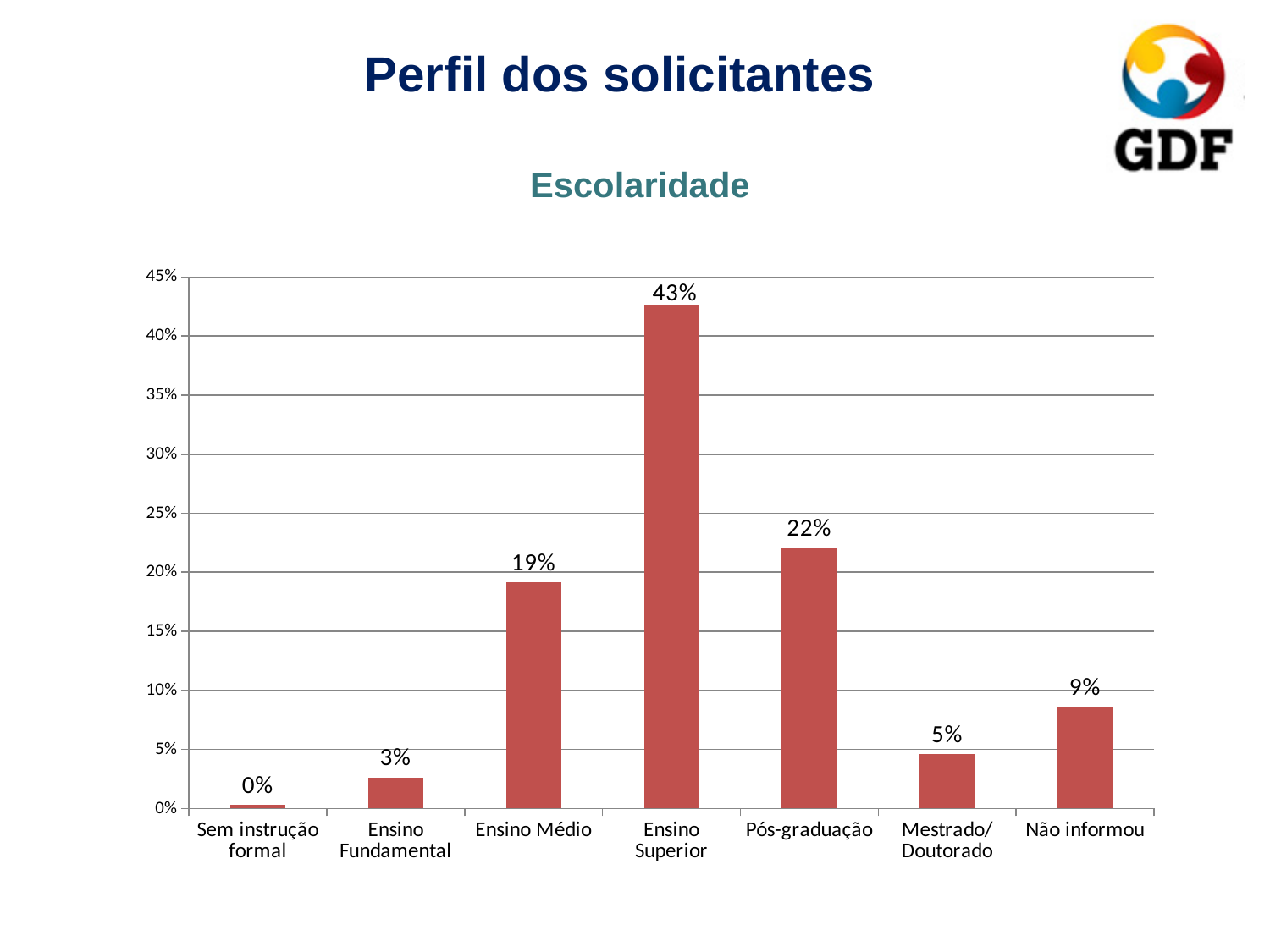
What is the value for Pós-graduação? 22% What is the difference between the values for Ensino Superior and Pós-graduação? 21% Which category has the highest value? Ensino Superior How many categories are shown on the x axis? 7 What is the title of the chart? Escolaridade What is the value for Ensino Superior? 43% Which is larger, the value for Ensino Médio or the value for Não informou? Ensino Médio Which category has the lowest value? Sem instrução formal What kind of chart is shown on the slide? Bar chart What is the difference between the values for Ensino Médio and Ensino Fundamental? 16% What is the value for Mestrado/Doutorado? 5% What is the value for Não informou? 9%